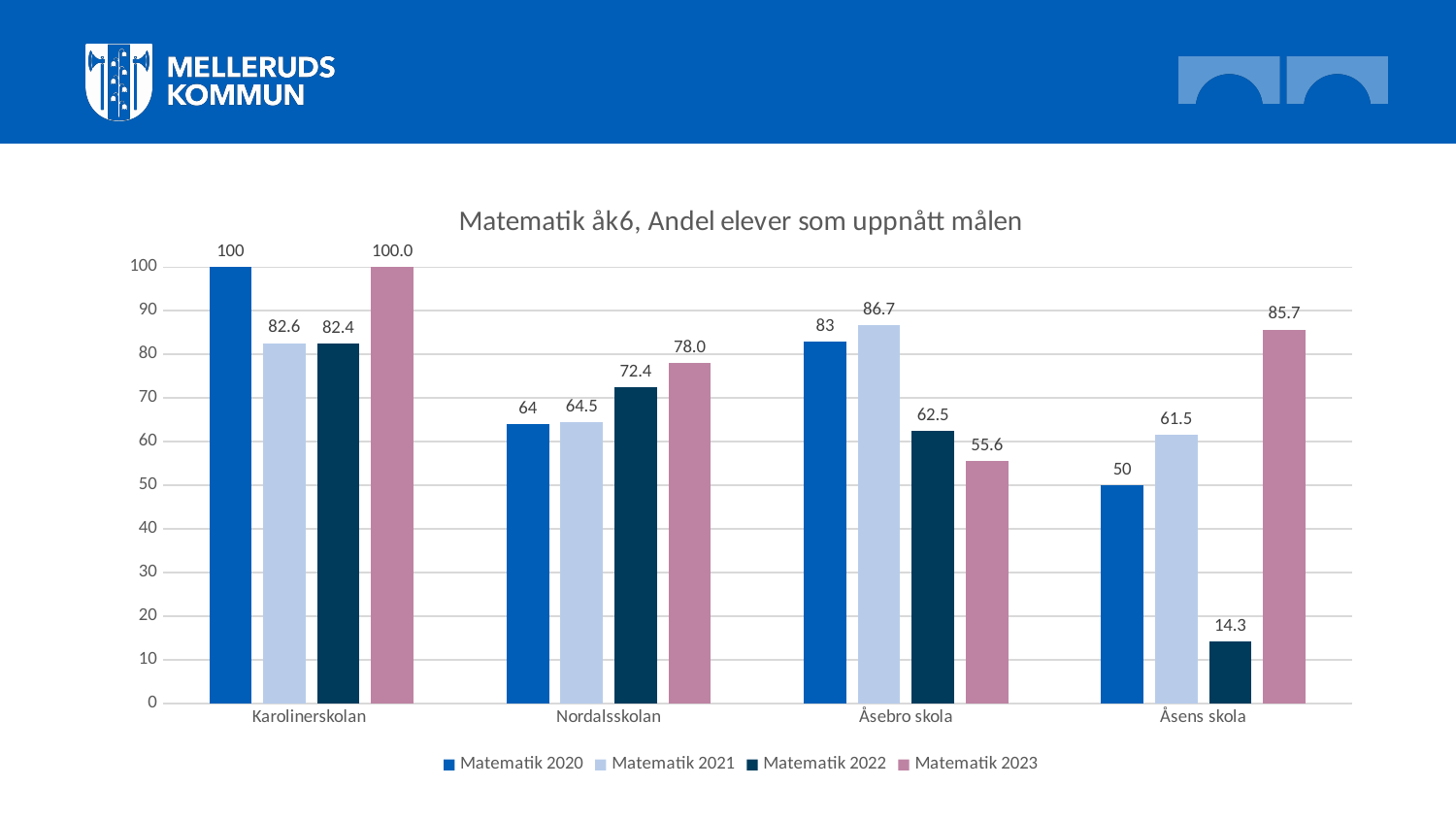
How many series does the legend list? 4 Do the values for Nordalsskolan rise or fall from Matematik 2020 to Matematik 2023? Rise Which school has the highest value for Matematik 2022? Karolinerskolan What kind of chart is shown on the slide? Bar chart What is the value for Matematik 2021 at Åsebro skola? 86.7 What is the title of the chart? Matematik åk6, Andel elever som uppnått målen How many schools are shown on the x axis? 4 Which school has the lowest value for Matematik 2020? Åsens skola Which is larger at Åsebro skola: Matematik 2022 or Matematik 2023? Matematik 2022 What is the difference between the Matematik 2023 and Matematik 2022 values at Åsens skola? 71.4 What is the value for Matematik 2023 at Nordalsskolan? 78.0 What is the value for Matematik 2022 at Åsens skola? 14.3